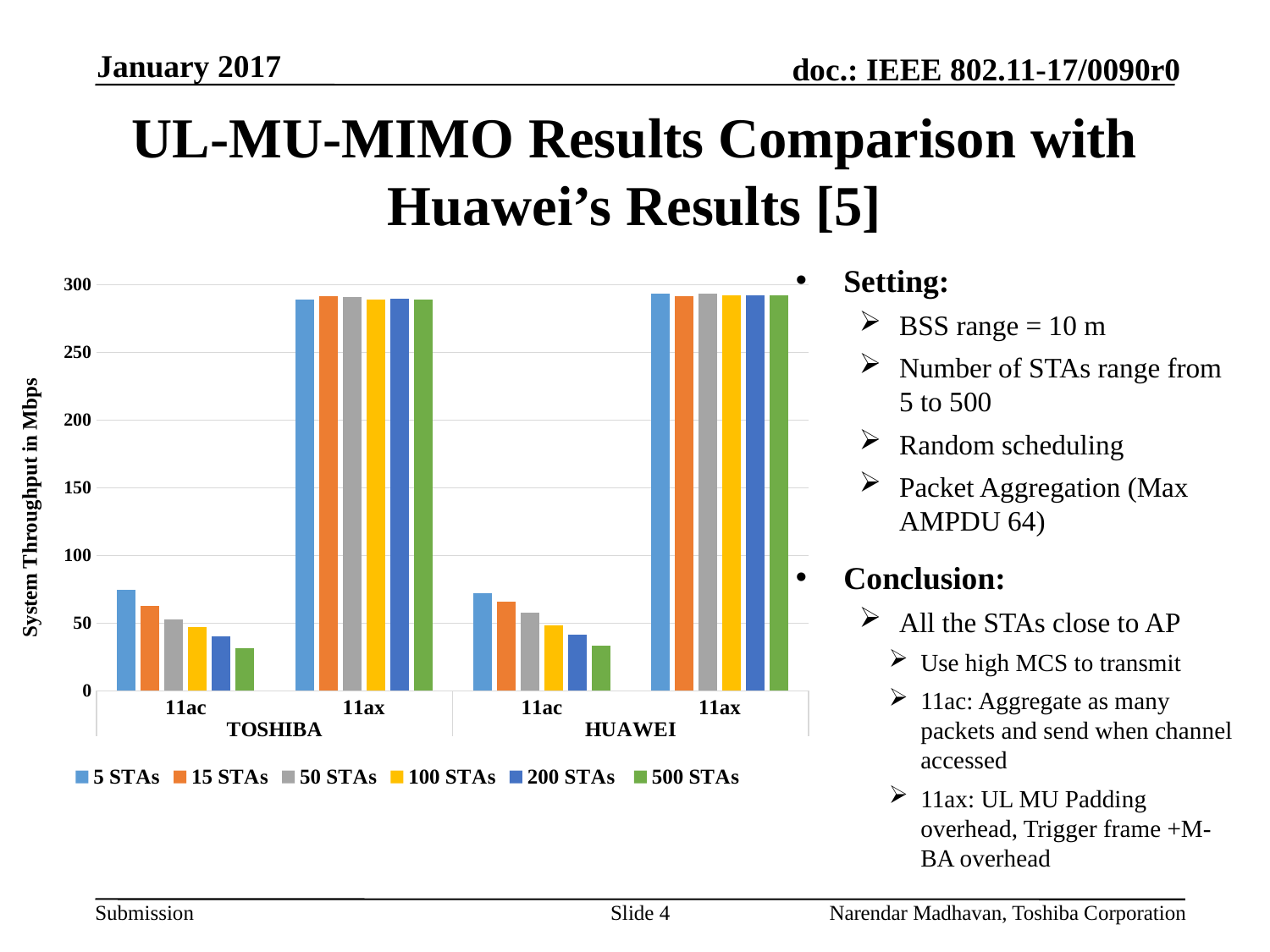
Is the value for 500 STAs under TOSHIBA 11ac greater or less than 50? less Is the value for 500 STAs under HUAWEI 11ac greater or less than 50? less How many category groups are shown along the x axis of the chart? 4 Within the TOSHIBA 11ac group, do the values rise or fall as the number of STAs increases from 5 to 500? fall Within the HUAWEI 11ac group, which series has the highest value? 5 STAs Within the TOSHIBA 11ac group, which series has the lowest value? 500 STAs How many series does the chart legend list? 6 Is the value for 5 STAs under TOSHIBA 11ax greater or less than 250? greater What is the label of the vertical axis of the chart? System Throughput in Mbps Which series is shown in green in the chart legend? 500 STAs What kind of chart is shown on the slide? bar chart